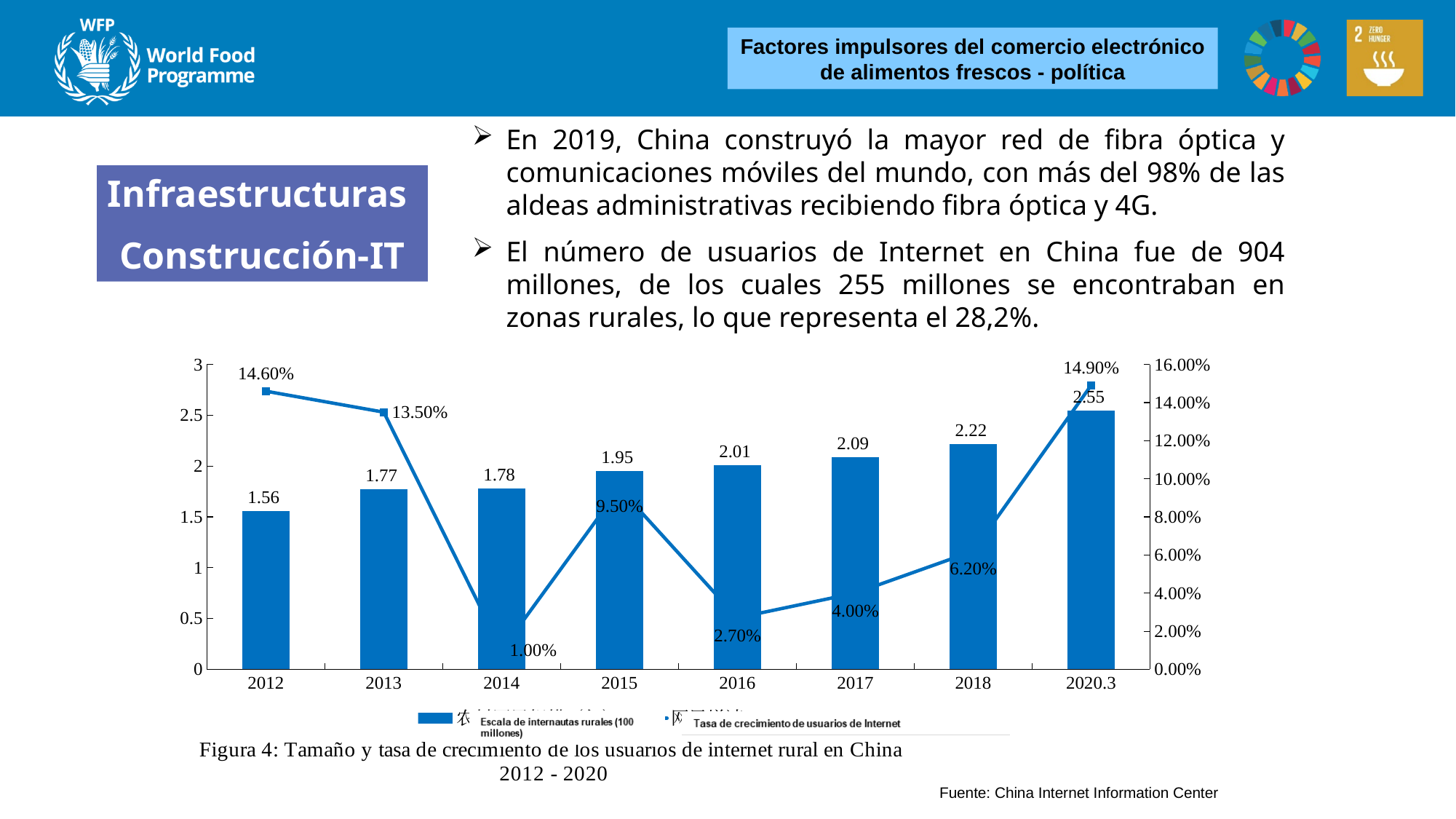
Which is larger, the growth rate for 2015 or the growth rate for 2018? 2015 Is the rural internet users bar value for 2018 greater or less than 2? greater What kind of chart is this? Combined bar and line chart What is the value of the rural internet users bar (Escala de internautas rurales) for 2016? 2.01 How many series does the legend list? 2 How many years (categories) are shown on the x axis? 8 What is the difference between the rural internet users bar values for 2020.3 and 2012? 0.99 What is the source cited for the chart? China Internet Information Center What growth rate (Tasa de crecimiento de usuarios de Internet) is shown for 2014? 1.00% Do the rural internet users bar values rise or fall from 2012 to 2020.3? rise Which year has the highest growth rate on the line series? 2020.3 Which year has the lowest value for the rural internet users bars? 2012